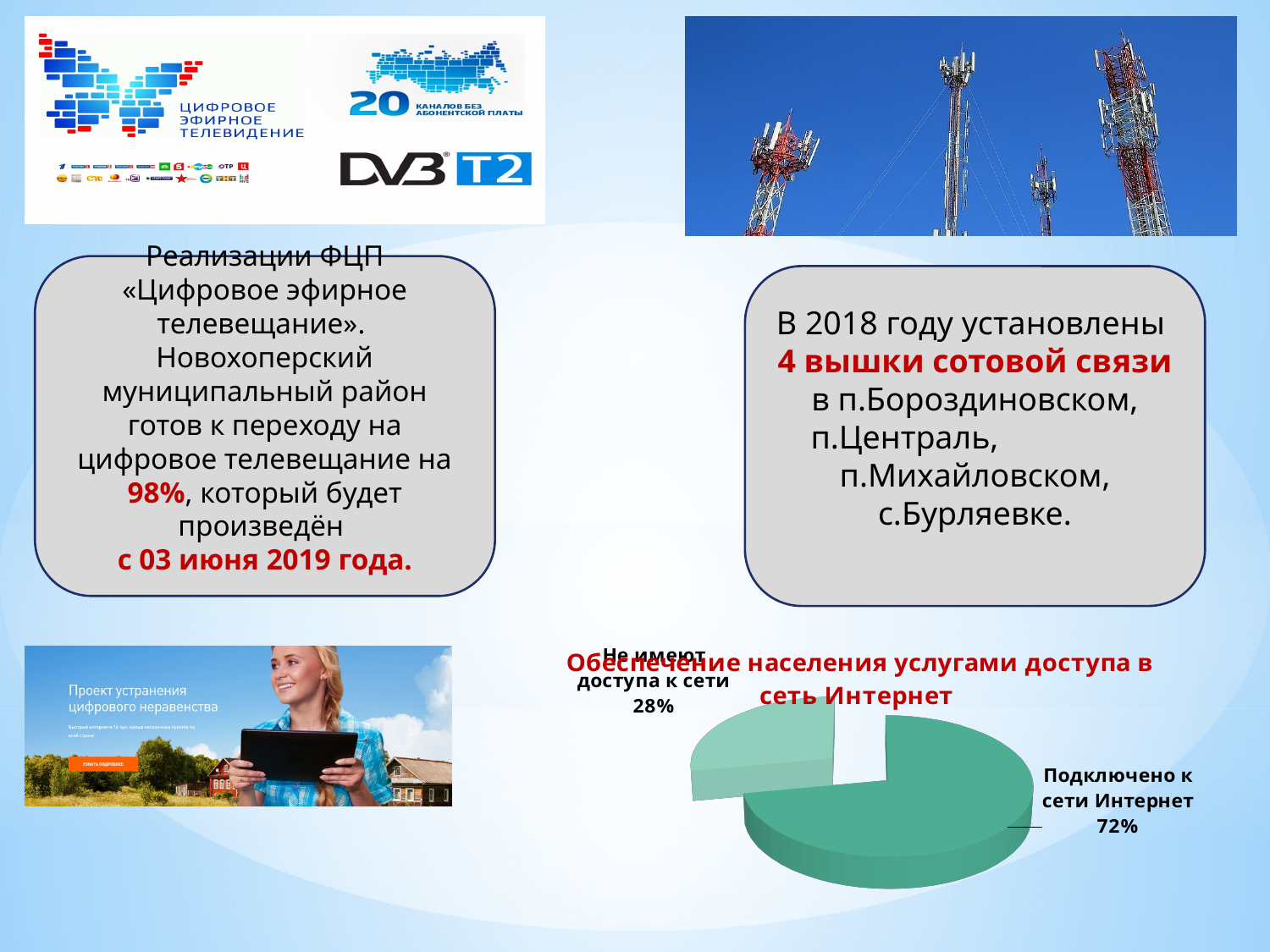
How many slices does the pie chart have? 2 Do the two slices of the pie chart add up to 100%? Yes By how many percentage points does the "Подключено к сети Интернет" slice exceed the "Не имеют доступа к сети" slice? 44 percentage points Is the share of the population connected to the Internet greater or less than 50%? greater Which is larger in the pie chart: "Подключено к сети Интернет" or "Не имеют доступа к сети"? Подключено к сети Интернет What share of the pie chart is labelled "Не имеют доступа к сети"? 28% Which slice of the pie chart is the smallest? Не имеют доступа к сети What kind of chart is shown on the slide? Pie chart What share of the pie chart is labelled "Подключено к сети Интернет"? 72% What is the title of the chart on the slide? Обеспечение населения услугами доступа в сеть Интернет Which slice of the pie chart is the largest? Подключено к сети Интернет